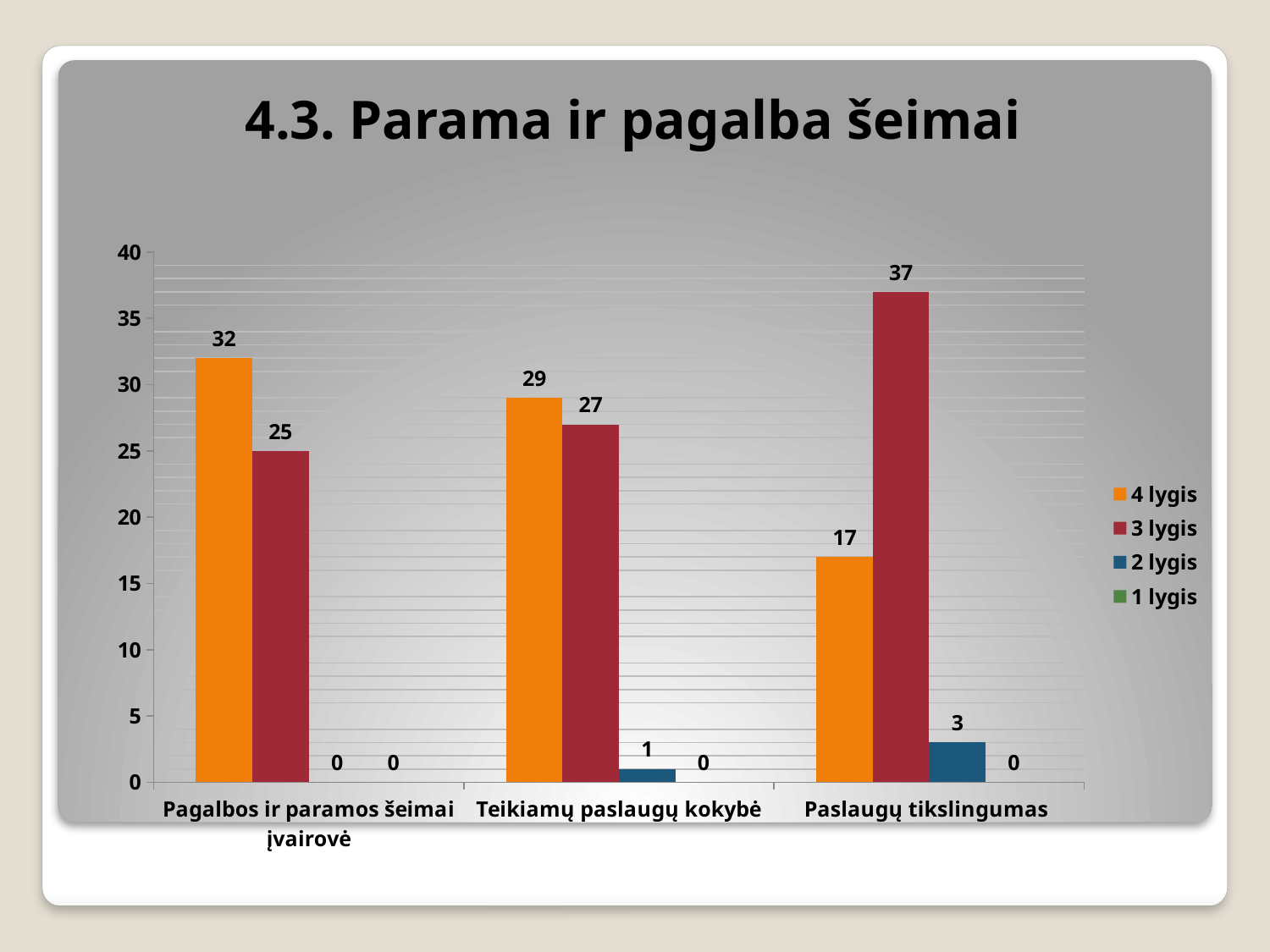
What is the difference between the 3 lygis and 4 lygis values for Paslaugų tikslingumas? 20 What is the title of the slide? 4.3. Parama ir pagalba šeimai Which category has the highest value for the 3 lygis series? Paslaugų tikslingumas Which category has the lowest value for the 4 lygis series? Paslaugų tikslingumas How many categories are shown on the x axis? 3 What is the value of the 2 lygis series for Teikiamų paslaugų kokybė? 1 Which is larger for Teikiamų paslaugų kokybė: the 4 lygis value or the 3 lygis value? 4 lygis What is the value of the 3 lygis series for Paslaugų tikslingumas? 37 How many series does the legend list? 4 What is the value of the 2 lygis series for Paslaugų tikslingumas? 3 What kind of chart is shown on the slide? Bar chart What is the value of the 4 lygis series for Pagalbos ir paramos šeimai įvairovė? 32